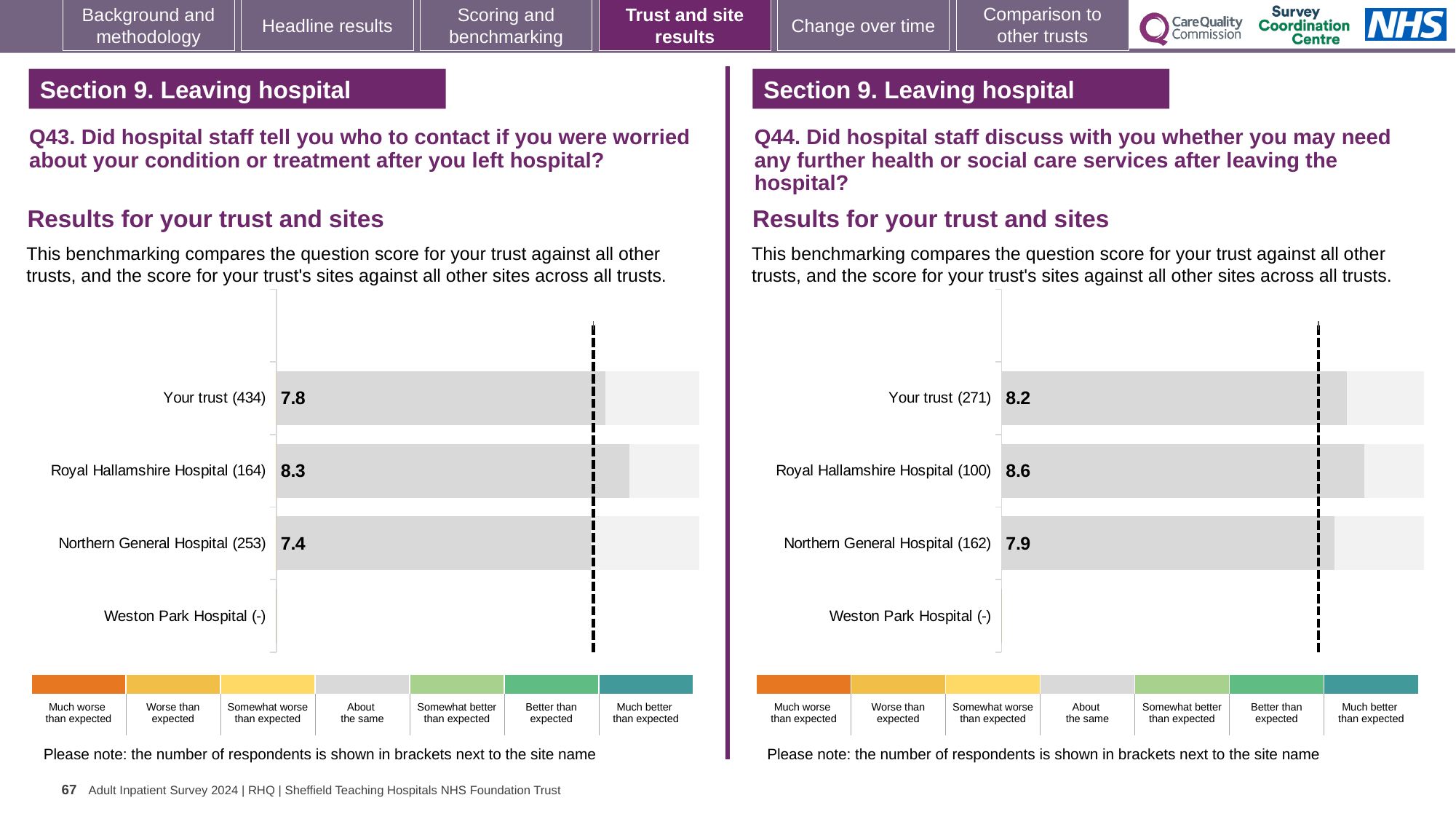
On the Q43 chart (left), what is the difference between the scores for Royal Hallamshire Hospital and Northern General Hospital? 0.9 On the Q43 chart (left), what is the score for Your trust? 7.8 On the Q44 chart (right), which is larger: the score for Your trust or the score for Northern General Hospital? Your trust On the Q43 chart (left), what is the score for Royal Hallamshire Hospital? 8.3 On the Q43 chart (left), how many respondents are shown in brackets for Northern General Hospital? 253 What kind of chart is used on the Q44 chart (right)? Bar chart On the Q43 chart (left), what is the score for Northern General Hospital? 7.4 On the Q44 chart (right), which site has the lowest score among those with a value shown? Northern General Hospital On the Q43 chart (left), which site has the highest score? Royal Hallamshire Hospital On the Q44 chart (right), what is the score for Your trust? 8.2 On the Q44 chart (right), what is the score for Northern General Hospital? 7.9 On the Q44 chart (right), what is the score for Royal Hallamshire Hospital? 8.6